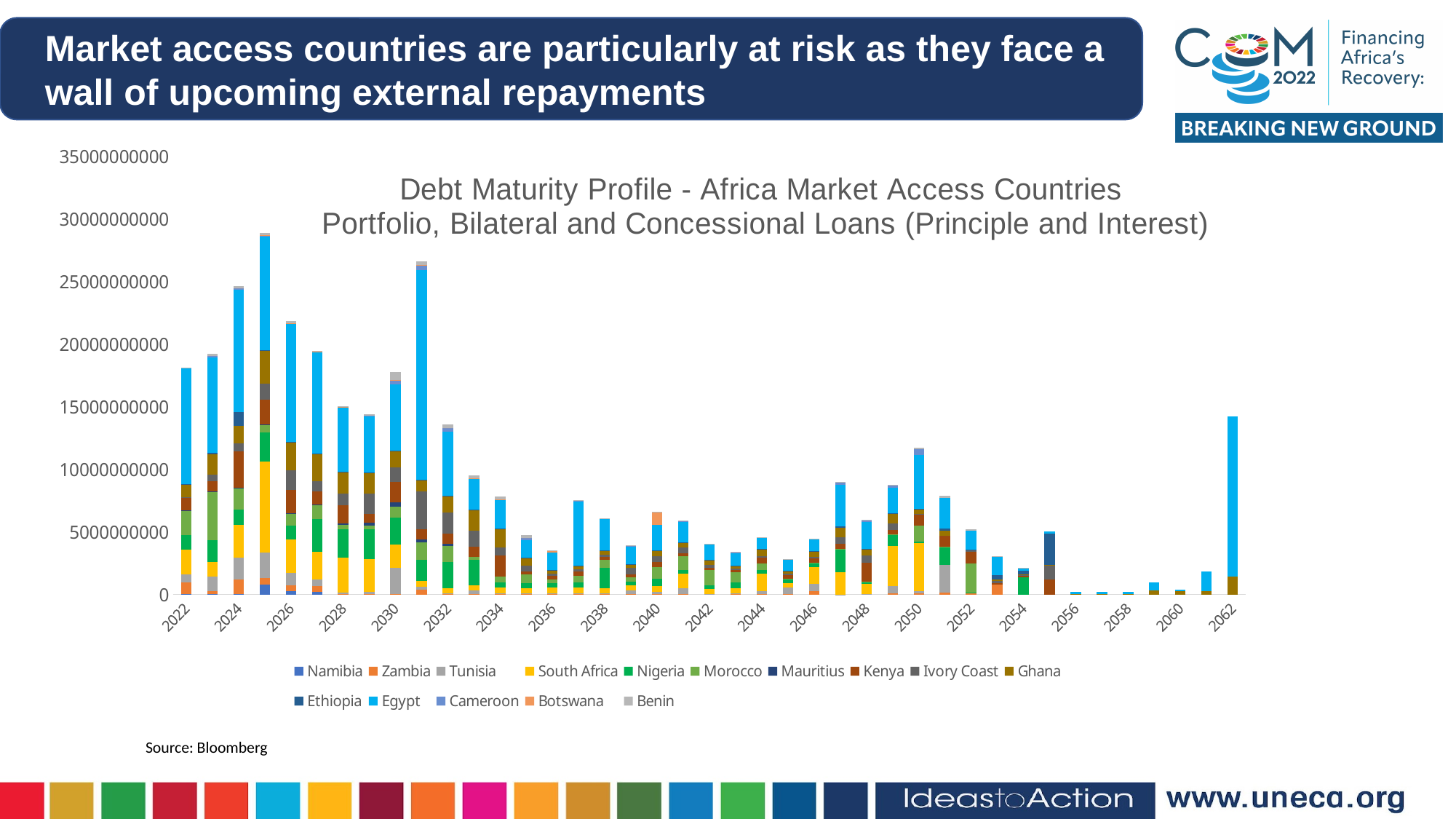
Is the total value of the 2022 bar greater or less than 15000000000? greater Which year has the taller total bar, 2022 or 2062? 2022 Do the total bar heights generally rise or fall between 2026 and 2036? fall What source is cited for the chart data? Bloomberg Is the total value of the 2056 bar greater or less than 5000000000? less How many series (countries) does the chart legend list? 15 Is the total value of the 2062 bar greater or less than 15000000000? less Which year has the taller total bar, 2024 or 2032? 2024 What kind of chart is shown on the slide? Stacked bar chart What is the title of the chart? Debt Maturity Profile - Africa Market Access Countries Portfolio, Bilateral and Concessional Loans (Principle and Interest)